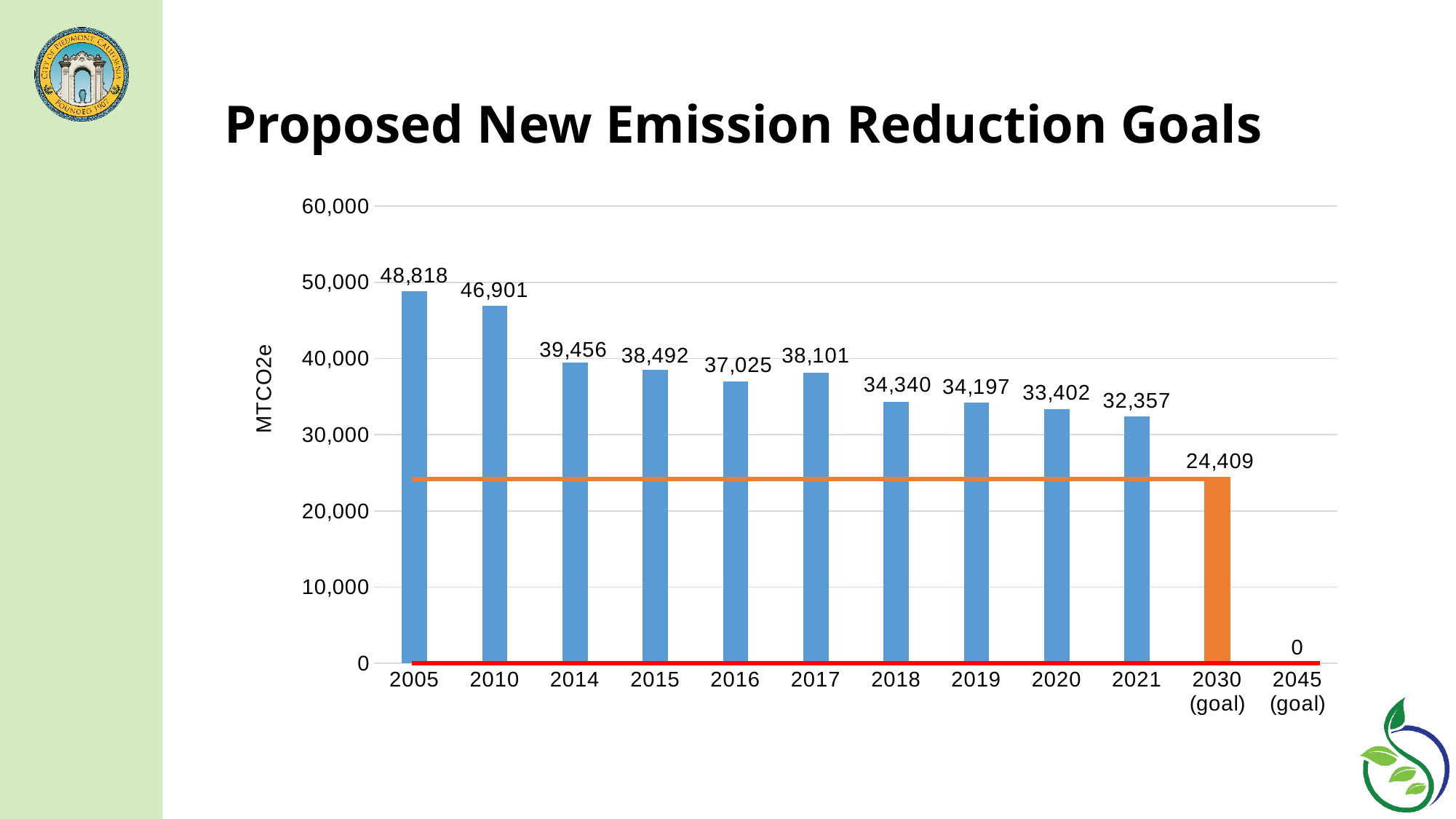
Which category has the lowest value? 2045 (goal) Which year has the highest value? 2005 What is the difference between the 2005 value and the 2021 value? 16,461 Do the values generally rise or fall from 2005 to 2021? fall How many categories are shown on the x axis? 12 What is the value for the 2030 (goal) bar? 24,409 What is the value for 2005? 48,818 What is the value for 2021? 32,357 What kind of chart is this? bar chart What is the label on the vertical axis? MTCO2e Is the value for 2020 greater or less than 30,000? greater Which is larger, the value for 2016 or the value for 2017? 2017